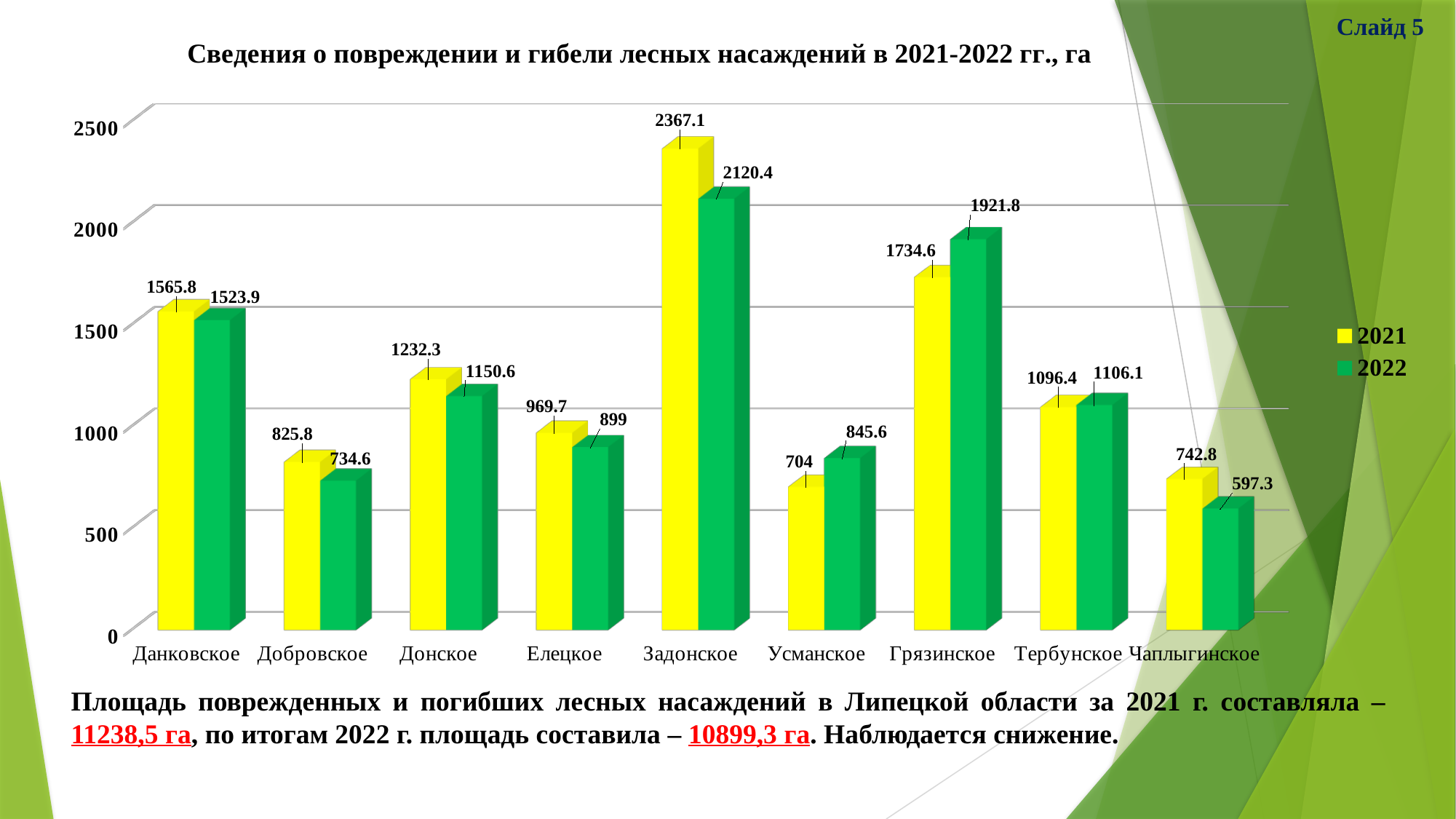
What kind of chart is shown on the slide? bar chart What is the 2021 value for Задонское? 2367.1 How many series does the legend list? 2 What is the 2022 value for Чаплыгинское? 597.3 What is the difference between the 2021 and 2022 values for Добровское? 91.2 What is the 2022 value for Усманское? 845.6 Which colour represents the 2021 series in the legend? yellow Which is larger for Грязинское, the 2021 value or the 2022 value? 2022 How many categories are shown on the x axis? 9 Is the 2021 value for Донское greater or less than 1000? greater Which category has the lowest 2021 value? Усманское Which category has the highest 2022 value? Задонское